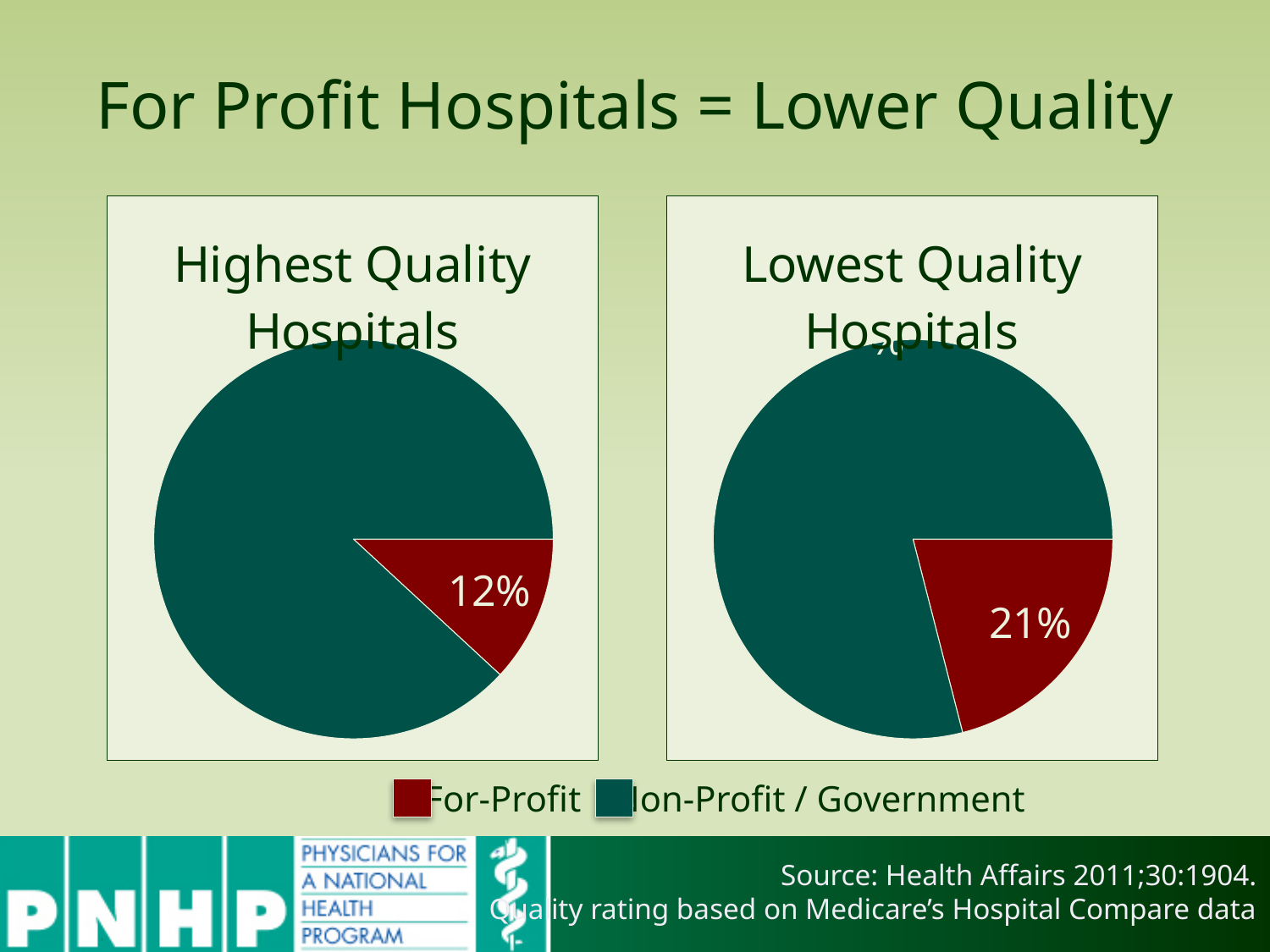
What colour represents For-Profit in the legend? Dark red Which chart shows the larger For-Profit share, Highest Quality Hospitals or Lowest Quality Hospitals? Lowest Quality Hospitals In the Lowest Quality Hospitals chart, which category has the smallest slice? For-Profit How many entries does the shared legend list? 2 What kind of chart is used for the Highest Quality Hospitals data? Pie chart What share of the Highest Quality Hospitals pie is For-Profit? 12% What is the difference between the For-Profit share in the Lowest Quality Hospitals chart and the For-Profit share in the Highest Quality Hospitals chart? 9% How many slices does the Lowest Quality Hospitals pie chart have? 2 How many pie charts are shown on the slide? 2 In the Highest Quality Hospitals chart, which category has the largest slice? Non-Profit / Government In the Highest Quality Hospitals chart, what percentage is shown for For-Profit? 12% In the Lowest Quality Hospitals chart, what percentage is shown for For-Profit? 21%